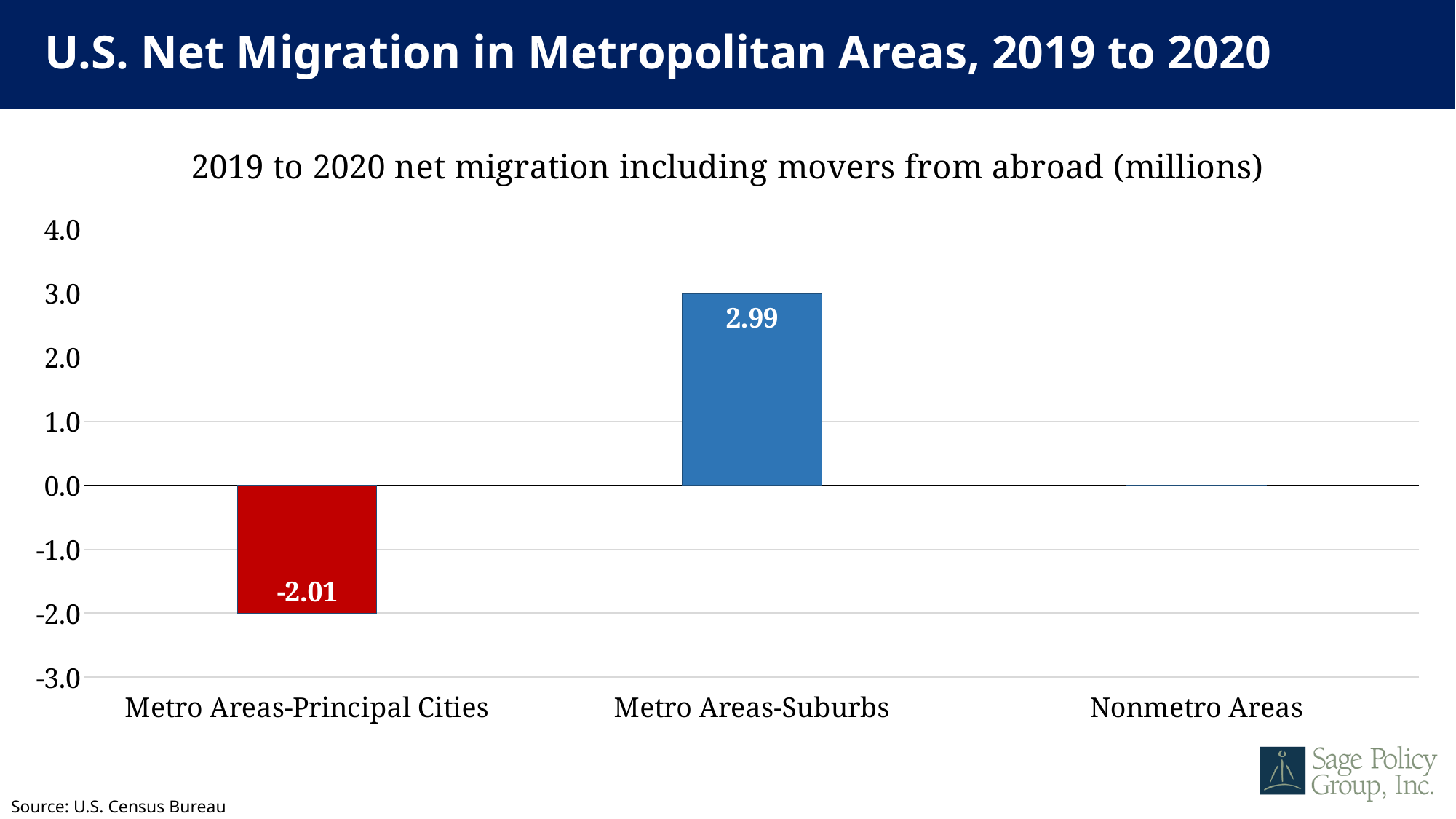
What is the net migration value for Metro Areas-Principal Cities? -2.01 Which category has the lowest net migration? Metro Areas-Principal Cities What colour is the bar for Metro Areas-Principal Cities? Red What is the net migration value for Metro Areas-Suburbs? 2.99 How many categories are shown on the x axis? 3 What is the title of the chart? 2019 to 2020 net migration including movers from abroad (millions) Which category has the highest net migration? Metro Areas-Suburbs What kind of chart is shown on the slide? Bar chart What is the difference between the net migration for Metro Areas-Suburbs and Metro Areas-Principal Cities? 5.00 Is the value for Nonmetro Areas greater or less than 1.0? less Which is larger, the net migration for Metro Areas-Suburbs or for Nonmetro Areas? Metro Areas-Suburbs Is the value for Nonmetro Areas greater or less than -1.0? greater